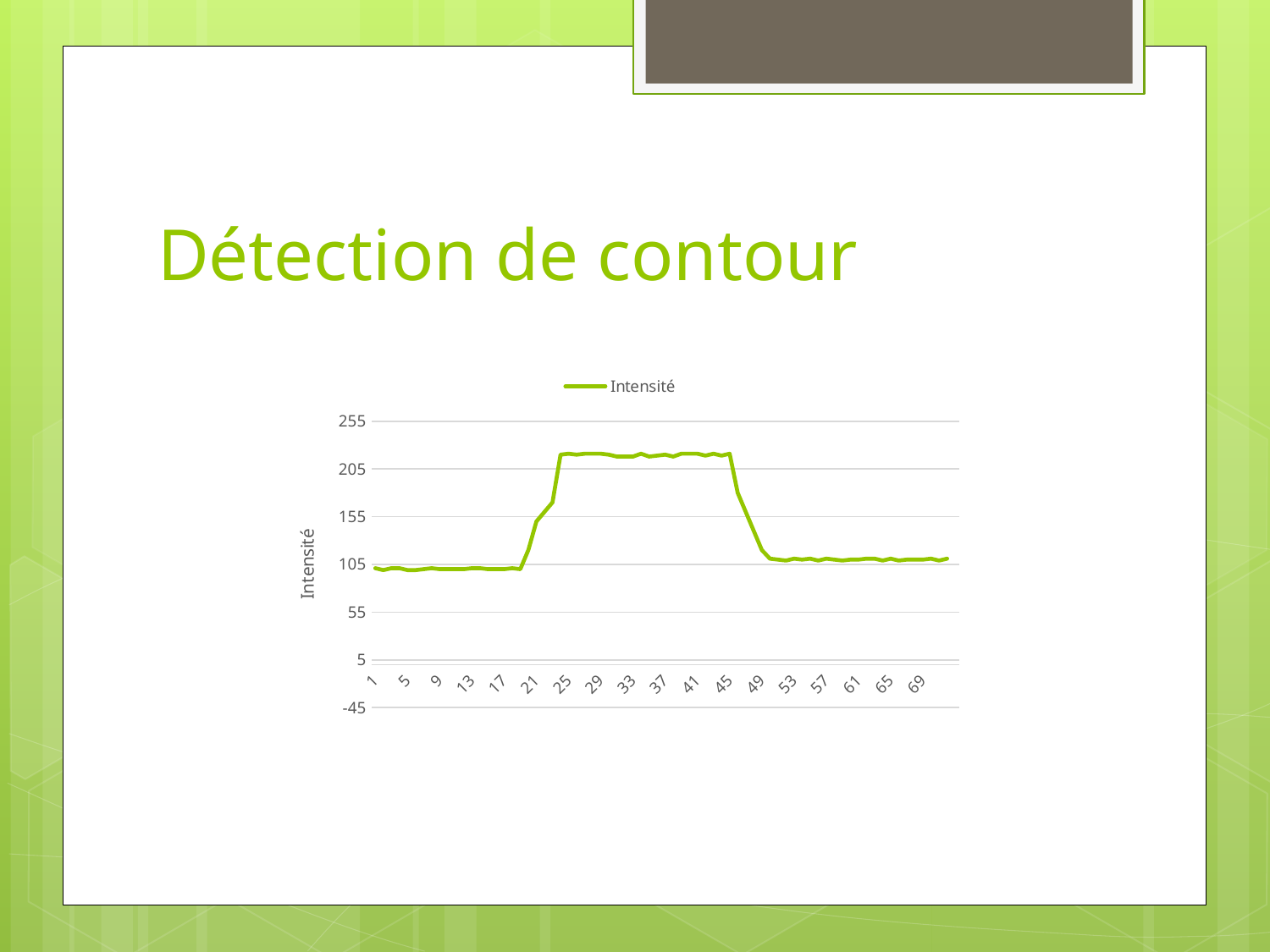
Is the value for 33 greater or less than 205? greater Is the value for 53 greater or less than 155? less How many series does the legend list? 1 What is the name of the series shown in the legend? Intensité What is the title of the vertical axis? Intensité Is the value for 25 greater or less than 155? greater Does the line rise or fall between 45 and 49? fall Does the line rise or fall between 17 and 25? rise Which has the larger value, 29 or 61? 29 What kind of chart is shown on the slide? line chart Which has the larger value, 33 or 9? 33